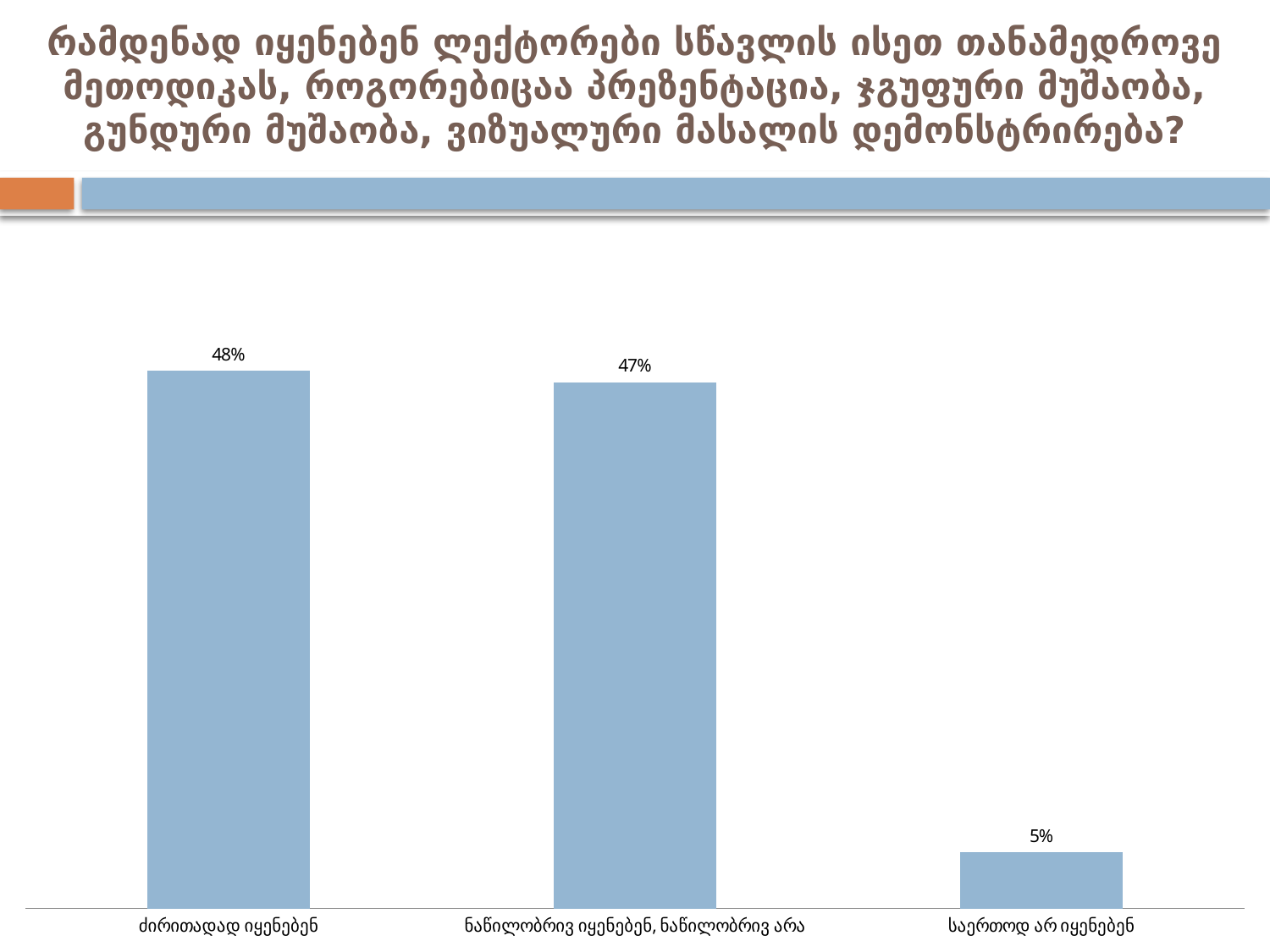
What is the difference between the values for "ძირითადად იყენებენ" and "ნაწილობრივ იყენებენ, ნაწილობრივ არა"? 1% How many categories are shown in the chart? 3 Which category has the highest value? ძირითადად იყენებენ Do the values rise or fall from left to right across the categories? fall What value is shown for the category "ნაწილობრივ იყენებენ, ნაწილობრივ არა"? 47% What is the difference between the values for "ძირითადად იყენებენ" and "საერთოდ არ იყენებენ"? 43% What value is shown for the category "ძირითადად იყენებენ"? 48% Which category has the lowest value? საერთოდ არ იყენებენ What colour are the bars in the chart? light blue Which is larger: the value for "ნაწილობრივ იყენებენ, ნაწილობრივ არა" or the value for "საერთოდ არ იყენებენ"? ნაწილობრივ იყენებენ, ნაწილობრივ არა What kind of chart is shown on the slide? bar chart What value is shown for the category "საერთოდ არ იყენებენ"? 5%